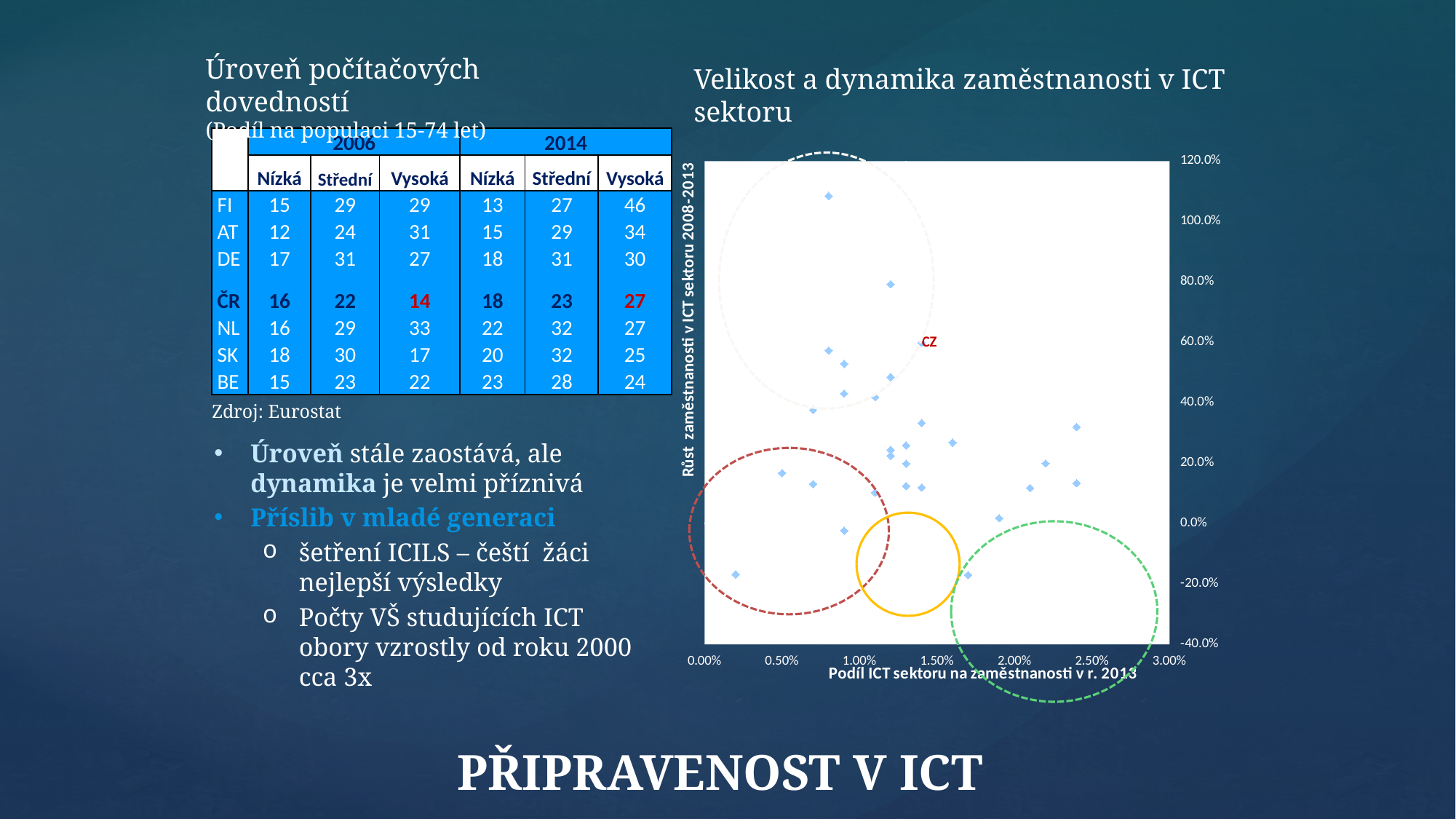
In the scatter chart, is the vertical-axis value of the highest point greater or less than 100.0%? greater In the scatter chart, what is the title of the horizontal axis? Podíl ICT sektoru na zaměstnanosti v r. 2013 What kind of chart is shown on the right side of the slide under the title 'Velikost a dynamika zaměstnanosti v ICT sektoru'? scatter chart In the scatter chart, what is the maximum value shown on the horizontal axis? 3.00% In the scatter chart, which point is labelled with a country code? CZ In the scatter chart, what is the title of the vertical axis? Růst zaměstnanosti v ICT sektoru 2008-2013 In the scatter chart, is the horizontal-axis value of the highest point greater or less than 1.50%? less In the scatter chart, is the horizontal-axis value of the point labelled CZ greater or less than 2.00%? less